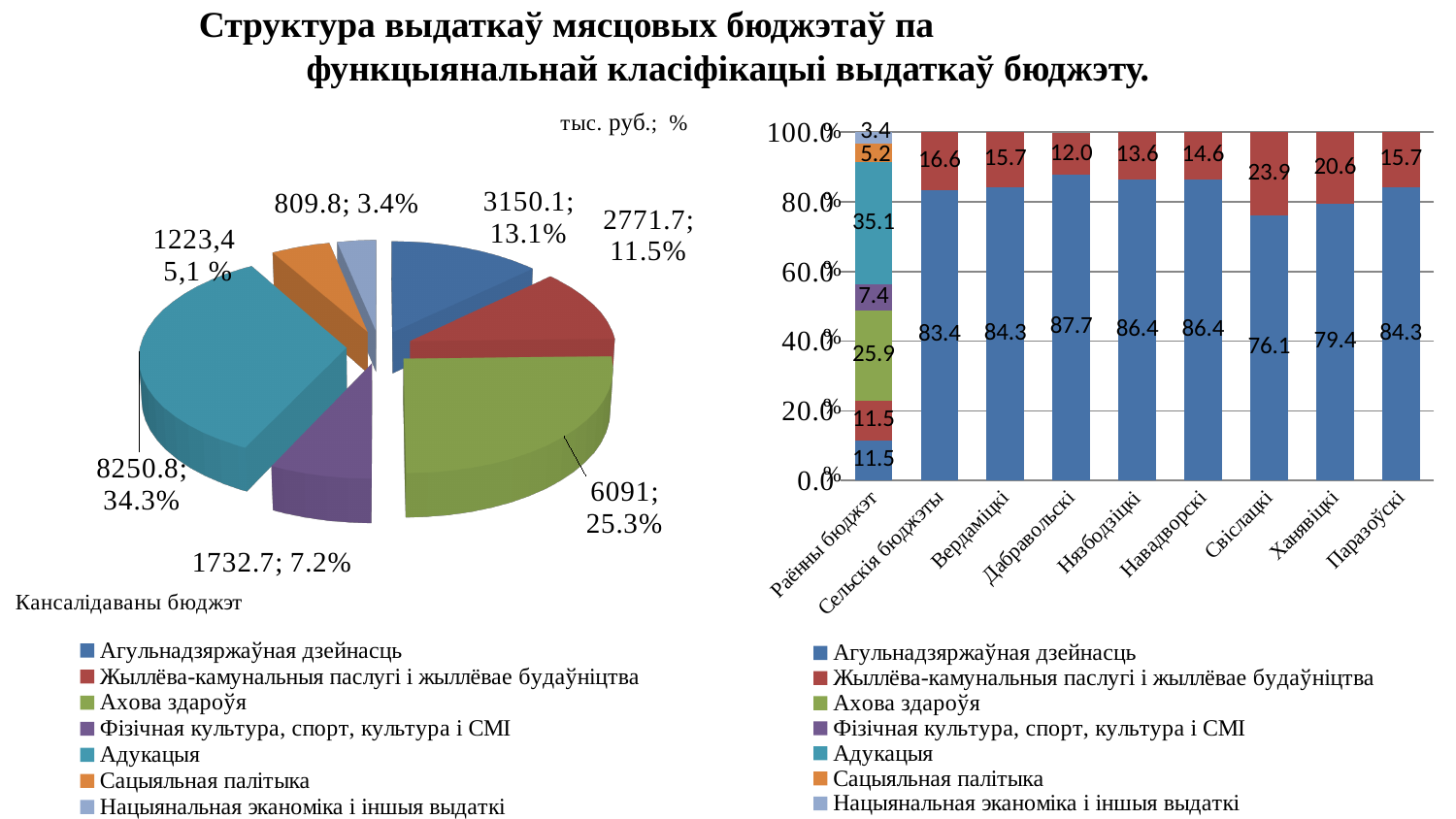
In the pie chart on the left, how many slices are there? 7 In the stacked bar chart on the right, how many categories are shown on the x axis? 9 In the pie chart on the left, what percentage is shown for Ахова здароўя? 25.3% What type of chart is on the right side of the slide? Stacked bar chart In the pie chart on the left, what is the difference in percentage points between Агульнадзяржаўная дзейнасць (13.1%) and Жыллёва-камунальныя паслугі і жыллёвае будаўніцтва (11.5%)? 1.6 In the stacked bar chart on the right, is the red segment larger for Ханявіцкі or for Вердаміцкі? Ханявіцкі In the stacked bar chart on the right, what is the value of the blue segment (Агульнадзяржаўная дзейнасць) for Дабравольскі? 87.7 In the stacked bar chart on the right, what is the value of the red segment for Свіслацкі? 23.9 In the stacked bar chart on the right, which category has the lowest value for the blue segment (Агульнадзяржаўная дзейнасць)? Раённы бюджэт In the pie chart on the left, which category has the smallest slice? Нацыянальная эканоміка і іншыя выдаткі In the pie chart on the left, which category has the largest slice? Адукацыя In the pie chart on the left, what is the value shown for Адукацыя? 8250.8; 34.3%